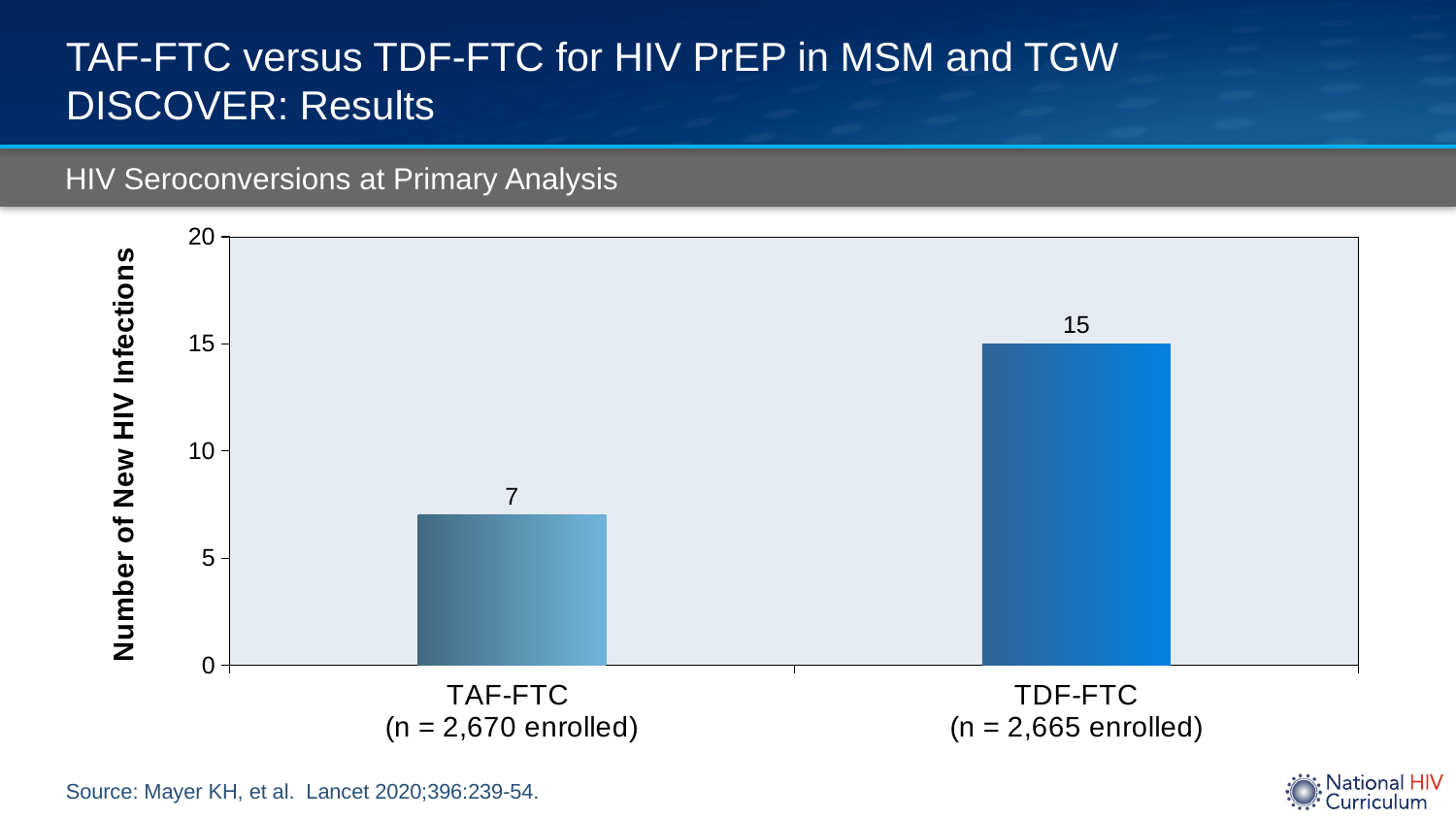
How many categories are shown on the x axis? 2 How many participants were enrolled in the TAF-FTC group according to the x-axis label? 2,670 What is the label of the y axis? Number of New HIV Infections Is the number of new HIV infections larger for TAF-FTC or TDF-FTC? TDF-FTC Is the value for TAF-FTC greater or less than 10? less Which group had the lower number of new HIV infections? TAF-FTC What is the number of new HIV infections for TAF-FTC? 7 Which group had the higher number of new HIV infections? TDF-FTC What is the difference in new HIV infections between TDF-FTC and TAF-FTC? 8 Is the value for TDF-FTC greater or less than 10? greater What kind of chart is shown on the slide? Bar chart What is the number of new HIV infections for TDF-FTC? 15